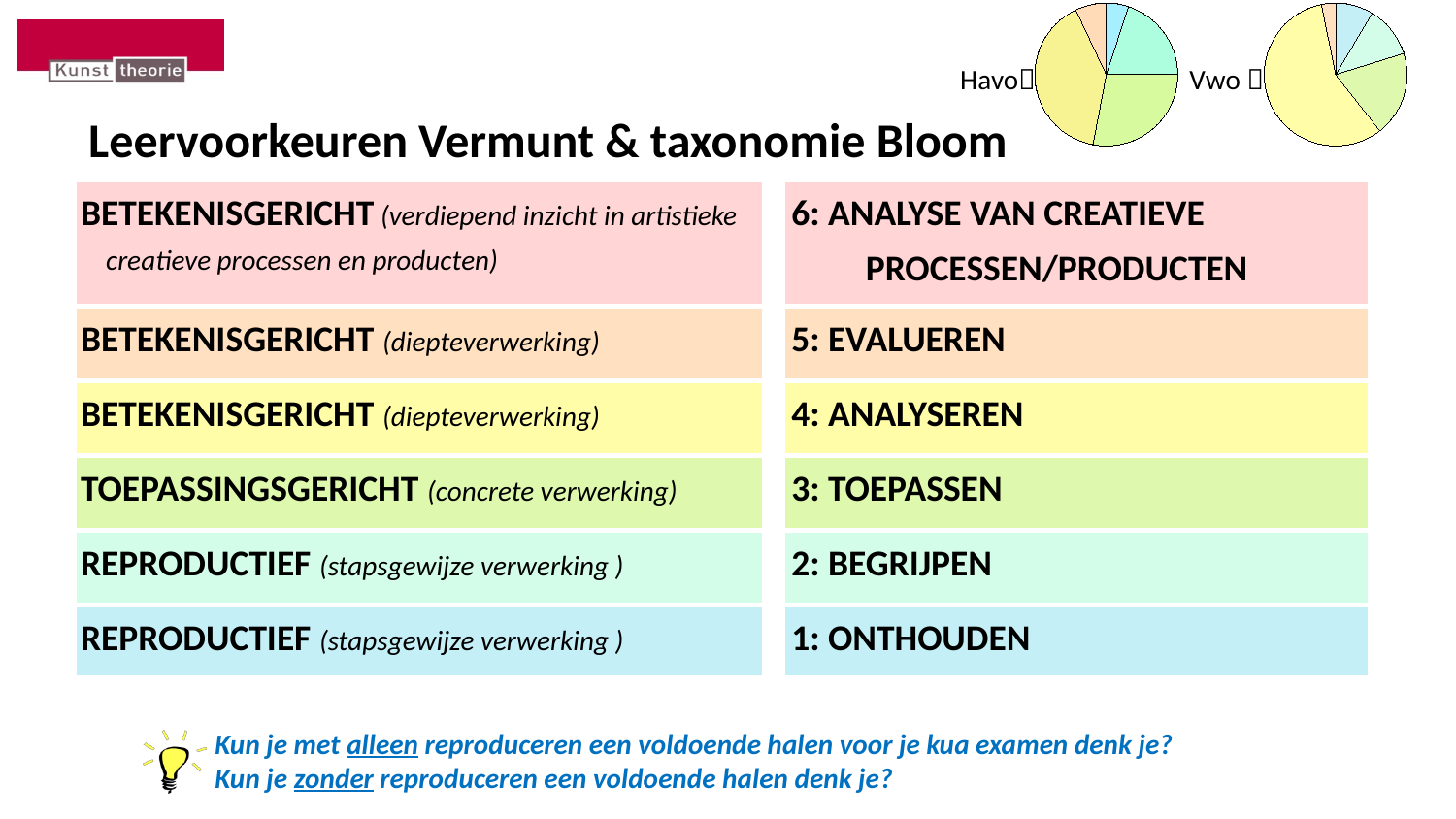
What kind of charts are shown at the top right of the slide? Pie charts In the Vwo pie chart, which colour slice is the largest? Yellow In the Vwo pie chart, is the yellow slice greater or less than half of the pie? greater In the Havo pie chart, is the yellow slice greater or less than half of the pie? less In the Havo pie chart, which colour slice is the largest? Yellow What are the labels of the two pie charts on the slide? Havo and Vwo Is the yellow slice larger in the Havo pie chart or in the Vwo pie chart? Vwo Which pie chart is positioned furthest to the right on the slide? Vwo How many pie charts are shown on the slide? 2